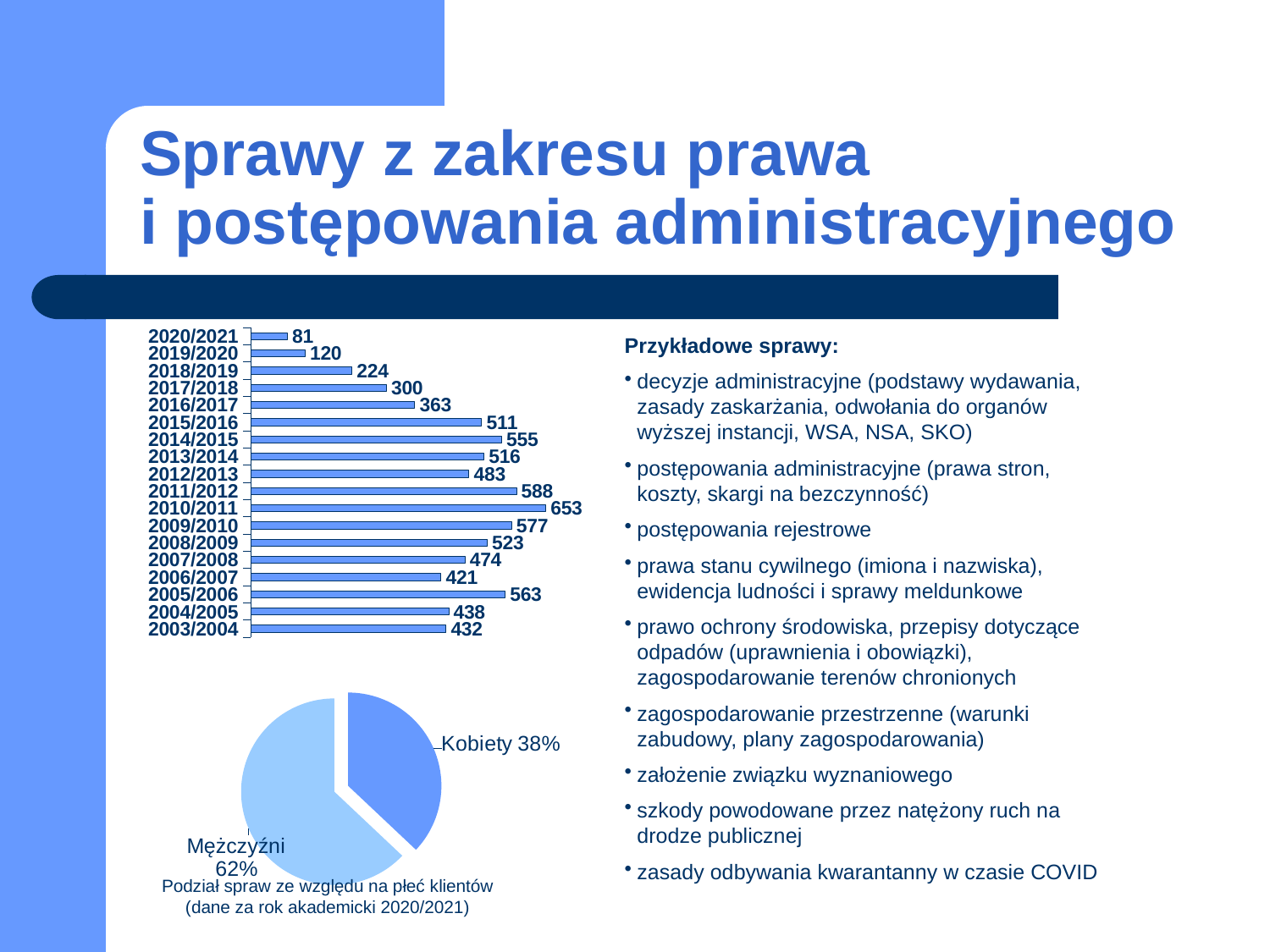
In the bar chart, what is the difference between the values for 2014/2015 and 2013/2014? 39 What type of chart is the upper chart on the left of the slide? bar chart In the bar chart, what is the value for 2010/2011? 653 In the pie chart, what share is labelled Mężczyźni? 62% In the bar chart, which academic year has the lowest value? 2020/2021 What is the caption of the pie chart? Podział spraw ze względu na płeć klientów (dane za rok akademicki 2020/2021) In the pie chart, what share is labelled Kobiety? 38% In the bar chart, which academic year has the highest value? 2010/2011 In the bar chart, which is larger, the value for 2005/2006 or the value for 2006/2007? 2005/2006 In the bar chart, what is the value for 2017/2018? 300 In the bar chart, do the values rise or fall from 2016/2017 to 2020/2021? fall How many academic years are shown in the bar chart? 18